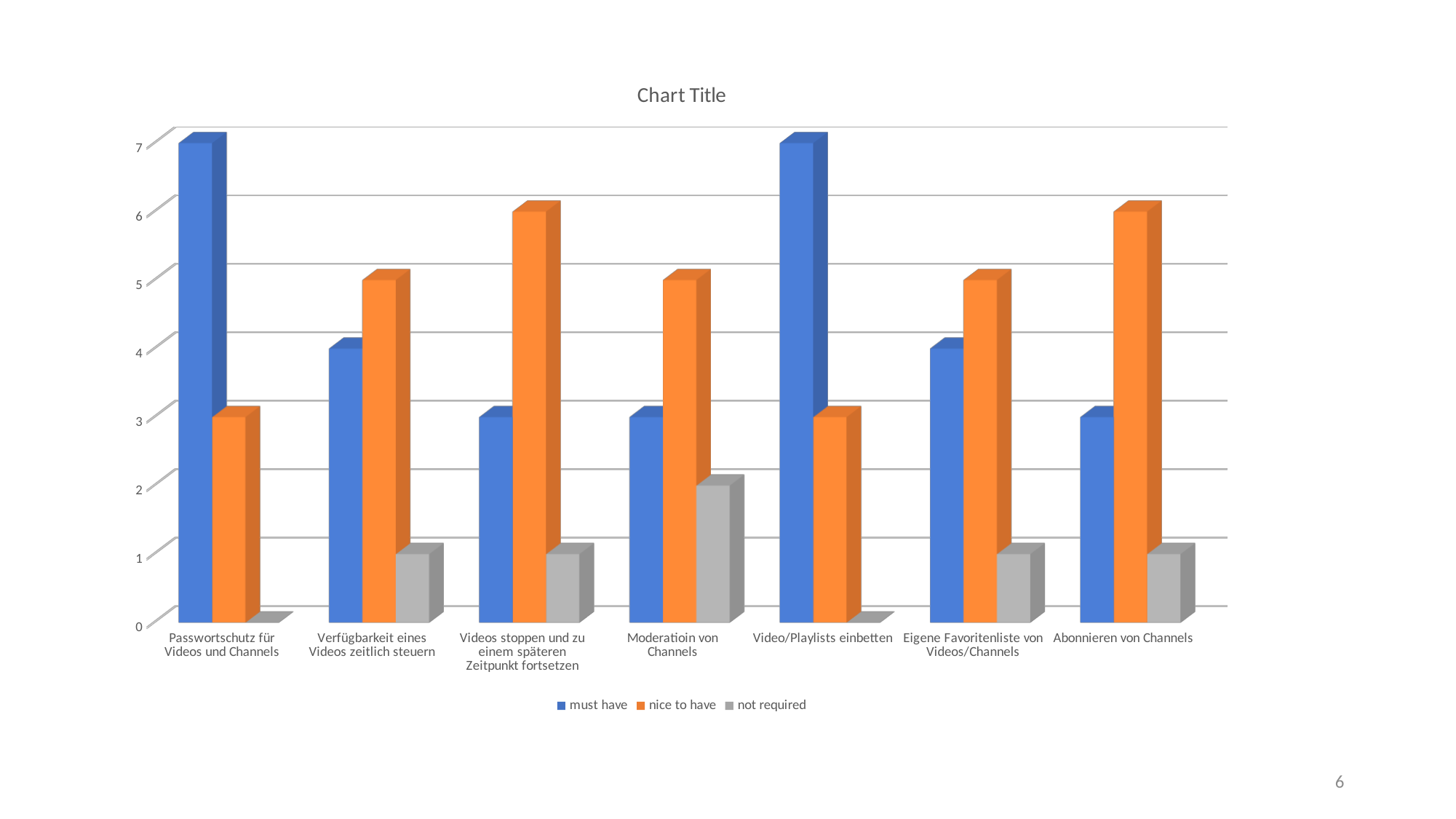
How many series does the legend list? 3 Which colour represents the 'nice to have' series? orange What kind of chart is shown on the slide? bar chart Which is larger for 'Verfügbarkeit eines Videos zeitlich steuern': the 'must have' value or the 'nice to have' value? nice to have How many categories are shown on the x axis? 7 Is the 'not required' value for 'Moderatioin von Channels' greater or less than 1? greater Is the 'must have' value for 'Abonnieren von Channels' greater or less than 4? less Is the 'must have' value for 'Passwortschutz für Videos und Channels' greater or less than 6? greater Which category has the highest 'not required' value? Moderatioin von Channels Which is larger for 'Video/Playlists einbetten': the 'must have' value or the 'nice to have' value? must have What is the title of the chart? Chart Title